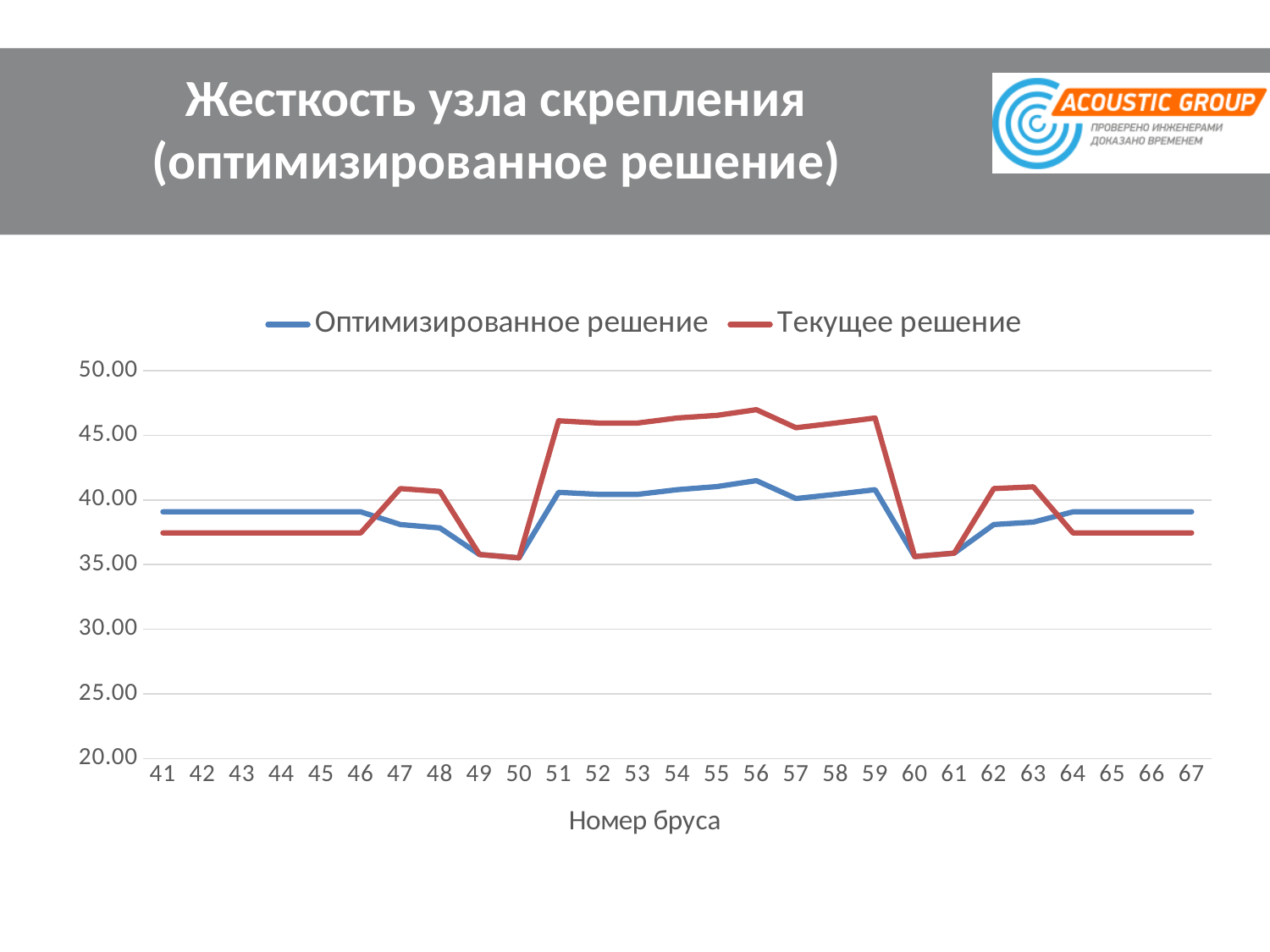
Which series is drawn in red? Текущее решение Is the value of Оптимизированное решение at bar number 49 greater or less than 40.00? less What is the title of the x axis? Номер бруса At bar number 41, which series has the higher value? Оптимизированное решение Is the value of Текущее решение at bar number 56 greater or less than 45.00? greater Is the value of Оптимизированное решение at bar number 56 greater or less than 45.00? less How many bar numbers (points) are plotted along the x axis? 27 How many series does the legend list? 2 At bar number 56, which series has the higher value? Текущее решение What kind of chart is shown on the slide? line chart Does the Текущее решение line rise or fall between bar numbers 59 and 60? fall